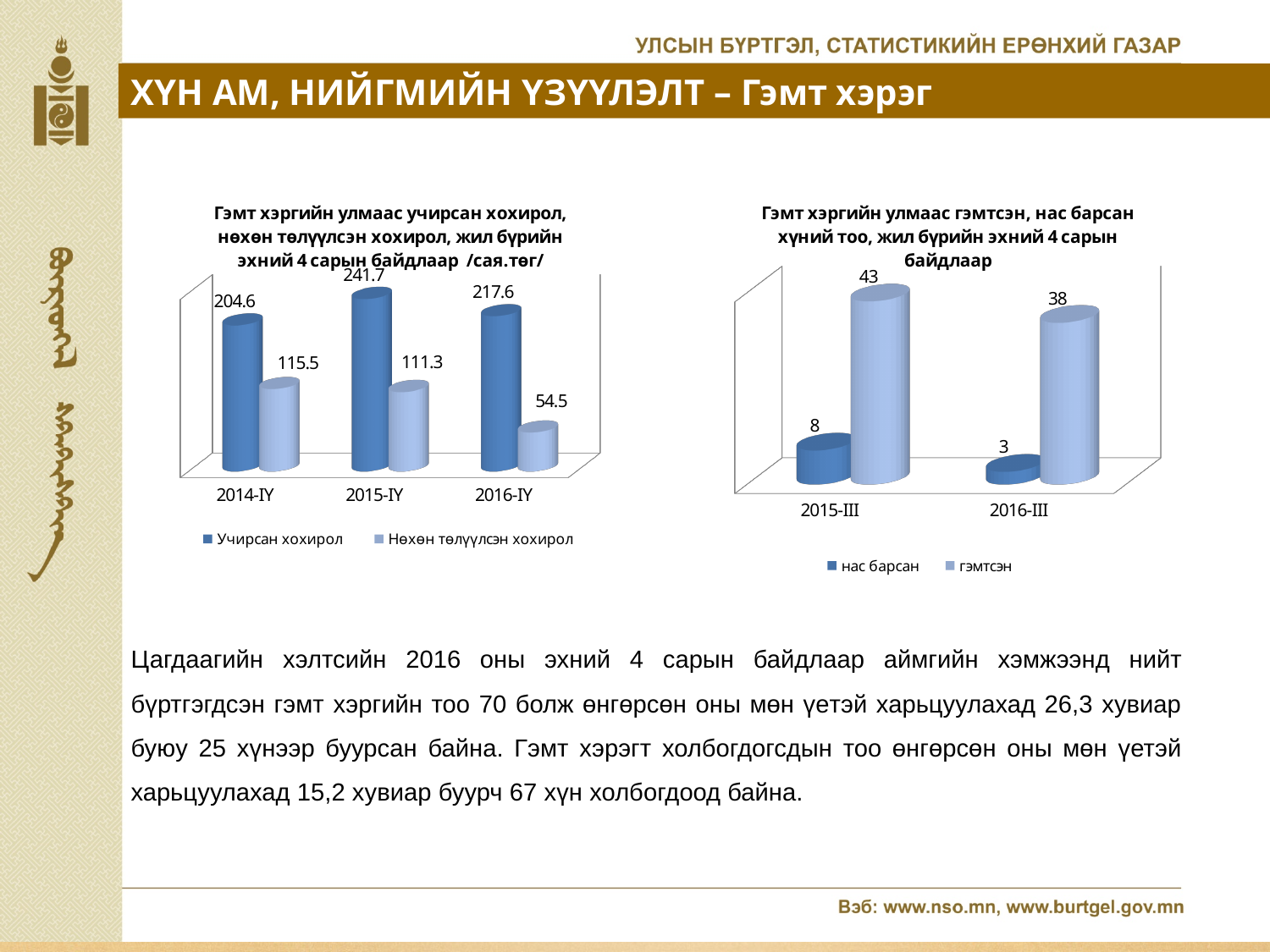
In the right chart, what is the value of нас барсан for 2016-III? 3 In the left chart, which period has the lowest Нөхөн төлүүлсэн хохирол value? 2016-IY In the left chart (Гэмт хэргийн улмаас учирсан хохирол...), what is the value of Учирсан хохирол for 2015-IY? 241.7 In the left chart, what is the difference between Учирсан хохирол and Нөхөн төлүүлсэн хохирол for 2014-IY? 89.1 In the right chart, what is the difference between гэмтсэн in 2015-III and 2016-III? 5 In the left chart, which period has the highest Учирсан хохирол value? 2015-IY In the right chart, how many categories are shown on the x axis? 2 In the left chart, what is the value of Нөхөн төлүүлсэн хохирол for 2016-IY? 54.5 In the left chart, how many series does the legend list? 2 In the left chart, does Нөхөн төлүүлсэн хохирол rise or fall from 2014-IY to 2016-IY? fall What type of chart is the right chart? bar chart In the right chart (Гэмт хэргийн улмаас гэмтсэн, нас барсан хүний тоо...), what is the value of гэмтсэн for 2015-III? 43